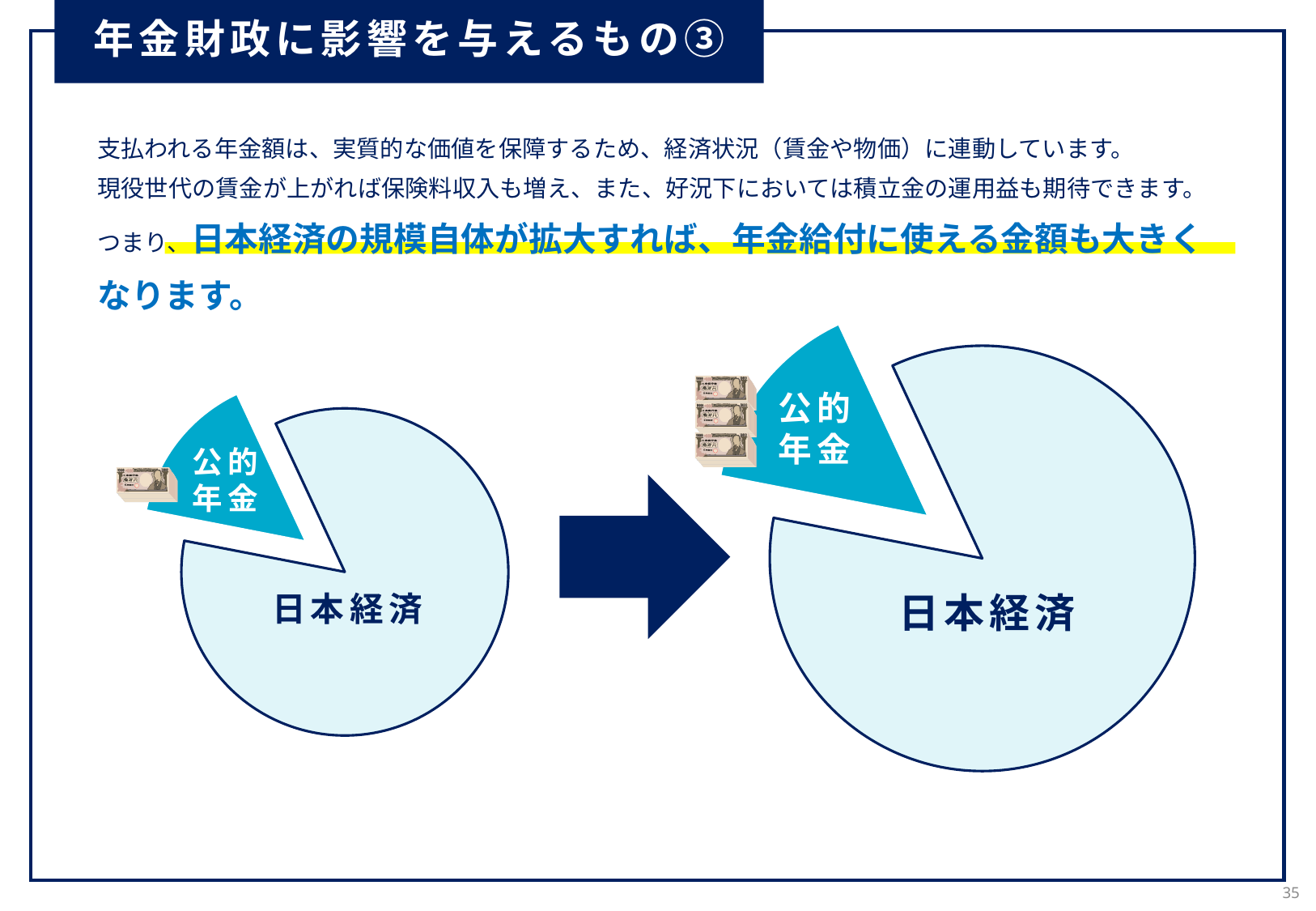
What is the label of the large light-blue slice in the right pie chart? 日本経済 What kind of chart is shown on the left side of the slide? pie chart What is the label of the slice pulled out from the pie in the left chart? 公的年金 In the left pie chart, which slice is larger, 日本経済 or 公的年金? 日本経済 In the right pie chart, which slice is the largest? 日本経済 How many pie charts are shown on the slide? 2 In the right pie chart, how many slices are there? 2 In the right pie chart, which slice is larger, 日本経済 or 公的年金? 日本経済 In the left pie chart, which slice is the smallest? 公的年金 Which pie chart is drawn larger overall, the left one or the right one? the right one In the left pie chart, how many slices are there? 2